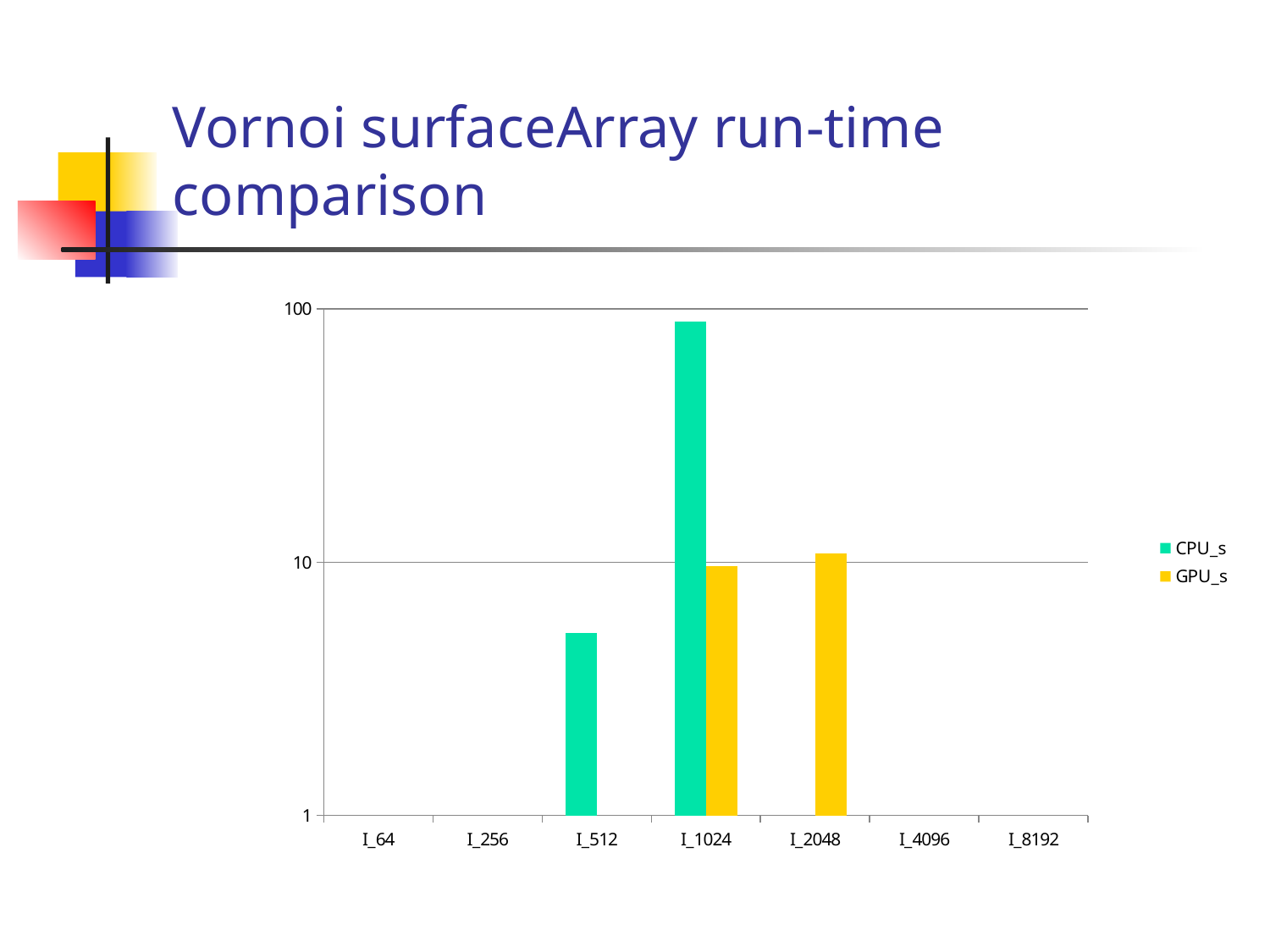
For I_1024, which series has the larger value, CPU_s or GPU_s? CPU_s Which category has the highest CPU_s value? I_1024 Is the CPU_s value for I_512 greater or less than 10? less Is the CPU_s value for I_1024 greater or less than 10? greater What is the title of the slide containing the chart? Vornoi surfaceArray run-time comparison How many categories are shown on the x axis? 7 Is the CPU_s value for I_1024 greater or less than 100? less How many series does the legend list? 2 Which colour represents the GPU_s series in the legend? yellow What kind of chart is shown on the slide? bar chart Which is larger, the CPU_s value for I_512 or the CPU_s value for I_1024? I_1024